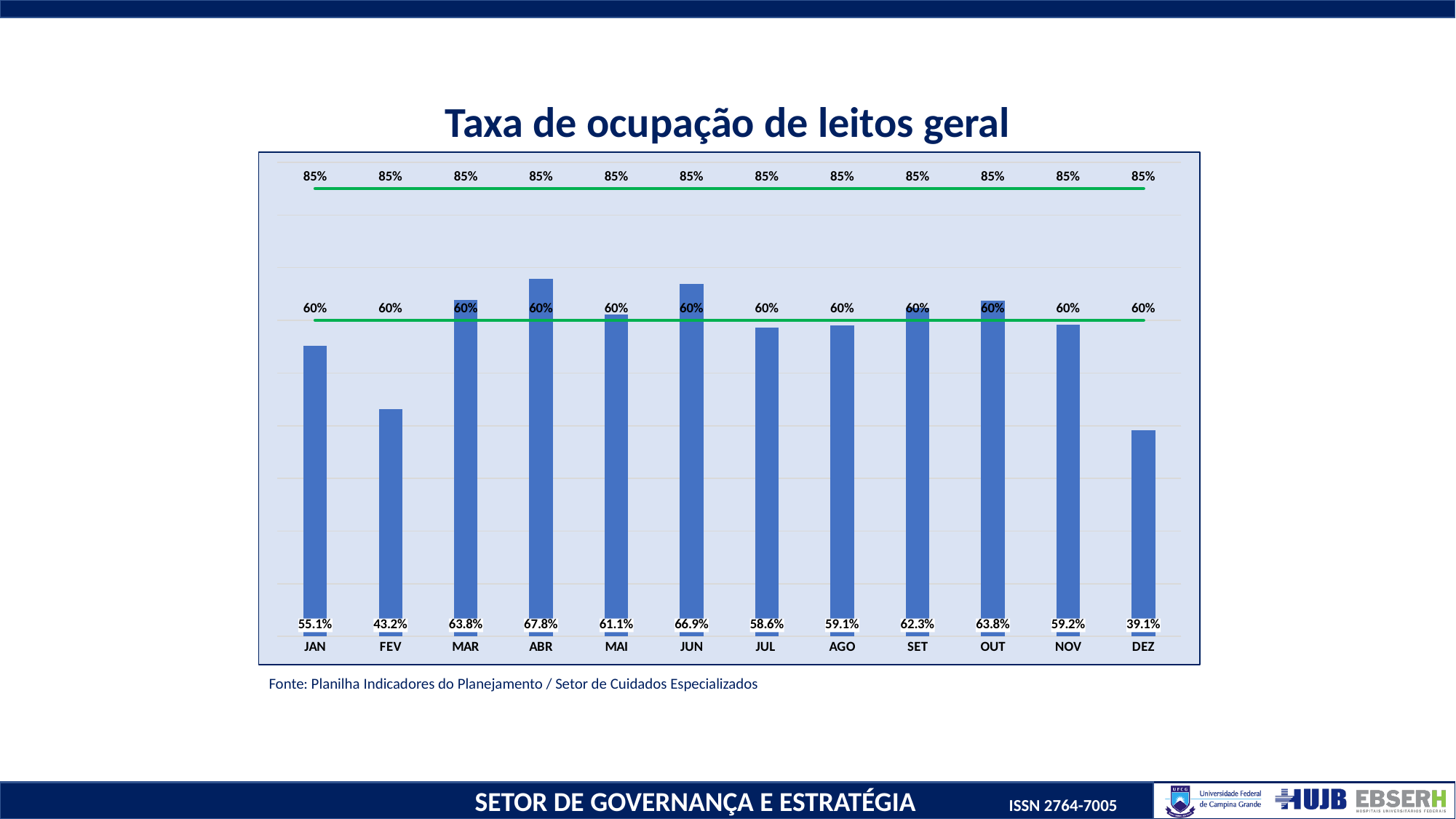
Is the value for NOV greater or less than the 60% reference line? less What is the value for JUN? 66.9% What is the difference between the values for ABR and DEZ? 28.7 percentage points What is the difference between the values for JUN and JAN? 11.8 percentage points Which is larger, the value for JAN or the value for FEV? JAN Which month has the highest occupancy rate? ABR Which month has the lowest occupancy rate? DEZ What value is shown for the bar labelled DEZ? 39.1% What is the value of the upper green reference line on the chart? 85% How many months are plotted on the chart? 12 What kind of chart is shown on the slide? bar chart What is the bed occupancy rate shown for ABR? 67.8%